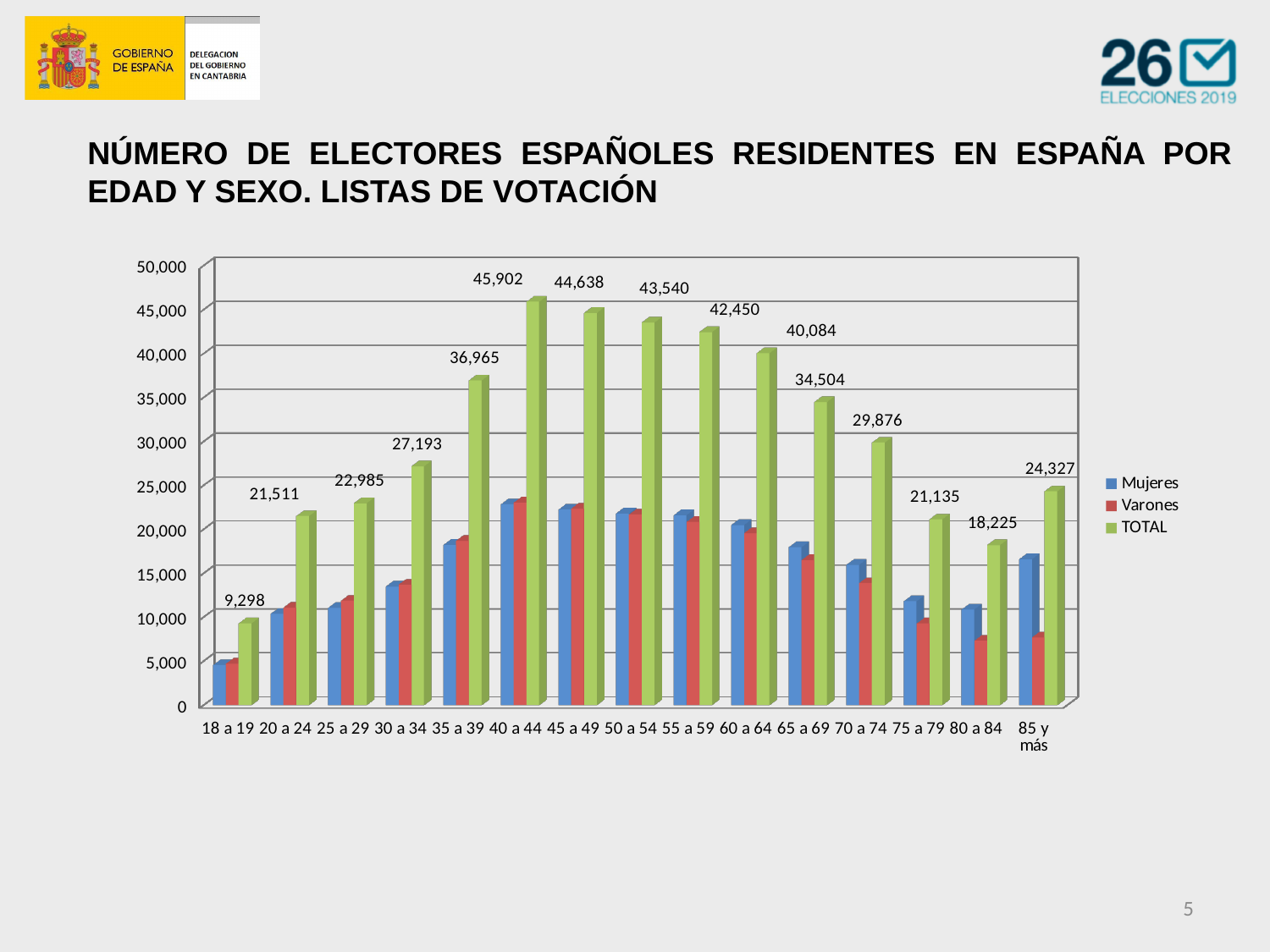
Does the TOTAL value rise or fall from 18 a 19 to 40 a 44? rise Is the Varones value for 80 a 84 greater or less than 10,000? less How many series does the legend list? 3 Which age group has the lowest TOTAL value? 18 a 19 Which has a larger TOTAL value, 70 a 74 or 65 a 69? 65 a 69 What is the TOTAL value for the 85 y más age group? 24,327 What is the difference between the TOTAL values for 40 a 44 and 45 a 49? 1,264 What is the TOTAL value for the 18 a 19 age group? 9,298 Which age group has the highest TOTAL value? 40 a 44 What is the TOTAL value for the 40 a 44 age group? 45,902 Is the Mujeres value for 85 y más greater or less than 15,000? greater How many age groups are shown on the x axis? 15